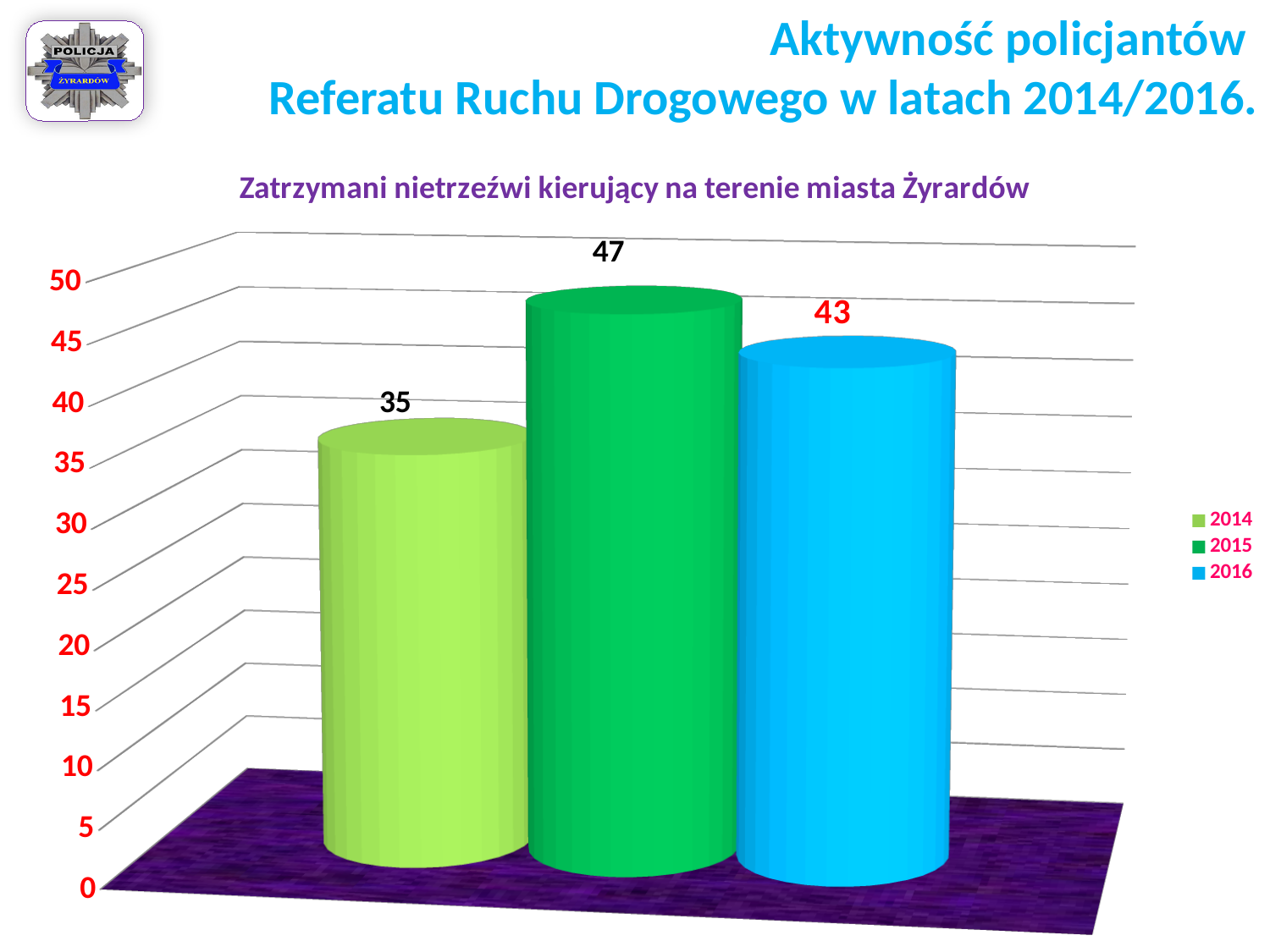
What kind of chart is shown on the slide? bar chart Which year has the lowest value? 2014 What is the title of the chart? Zatrzymani nietrzeźwi kierujący na terenie miasta Żyrardów What is the value for 2016 in the chart? 43 What is the value for 2014 in the chart? 35 Is the value for 2014 greater or less than 40? less What is the value for 2015 in the chart? 47 Which year has the highest value? 2015 What is the difference between the values for 2015 and 2014? 12 Which is larger, the value for 2016 or the value for 2014? 2016 How many series does the legend list? 3 What is the difference between the values for 2015 and 2016? 4